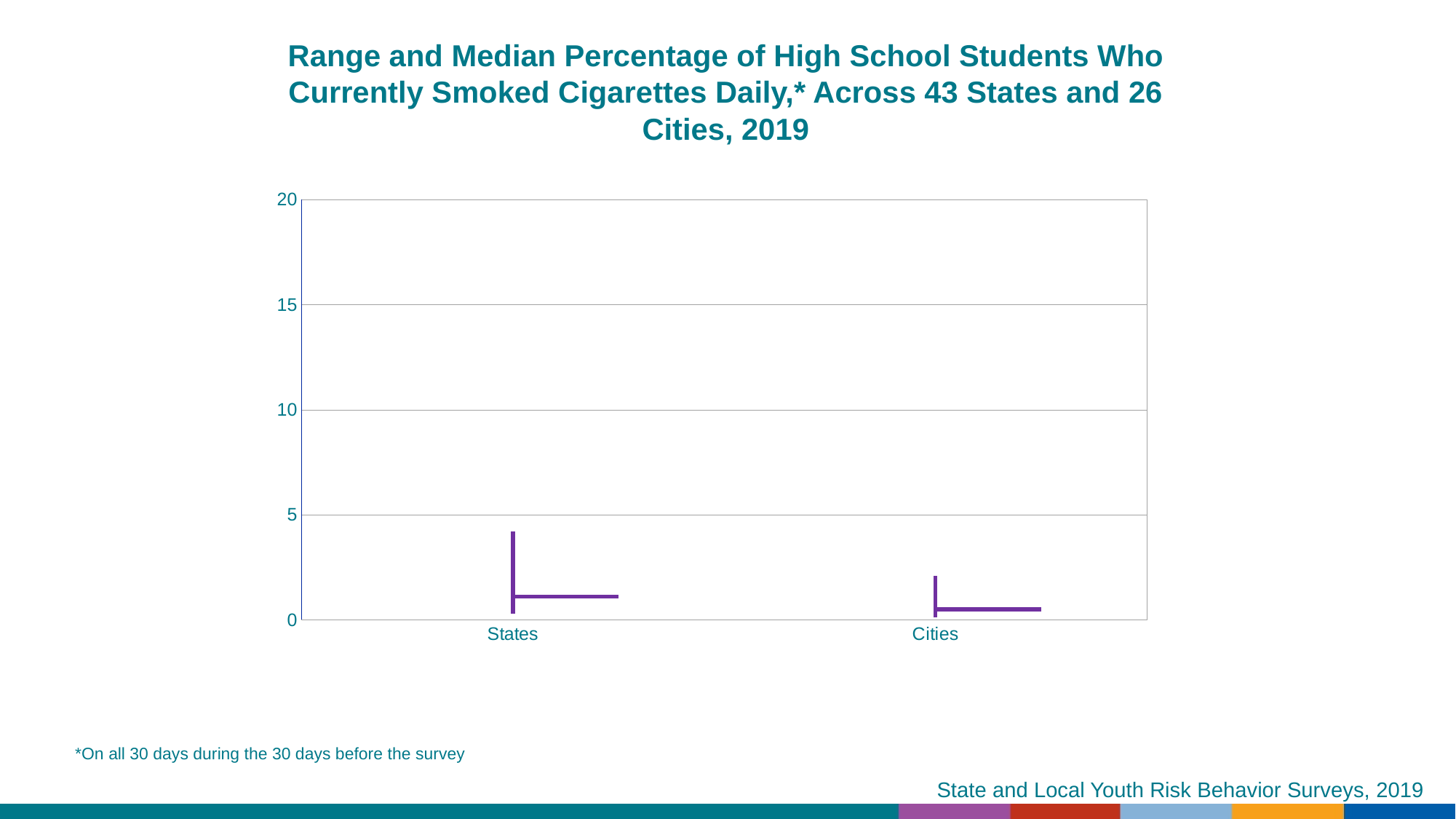
Is the top of the range for States greater or less than 5? less Which category has the higher top of its range, States or Cities? States Is the top of the range for Cities greater or less than 5? less What kind of chart is shown on the slide? A range (high-low) chart with median markers What is the maximum value shown on the y axis? 20 How many categories are shown on the x axis of the chart? 2 What are the two categories shown on the x axis? States and Cities Is the median for Cities greater or less than 5? less Which category has the higher median line, States or Cities? States Which category has the wider range, States or Cities? States